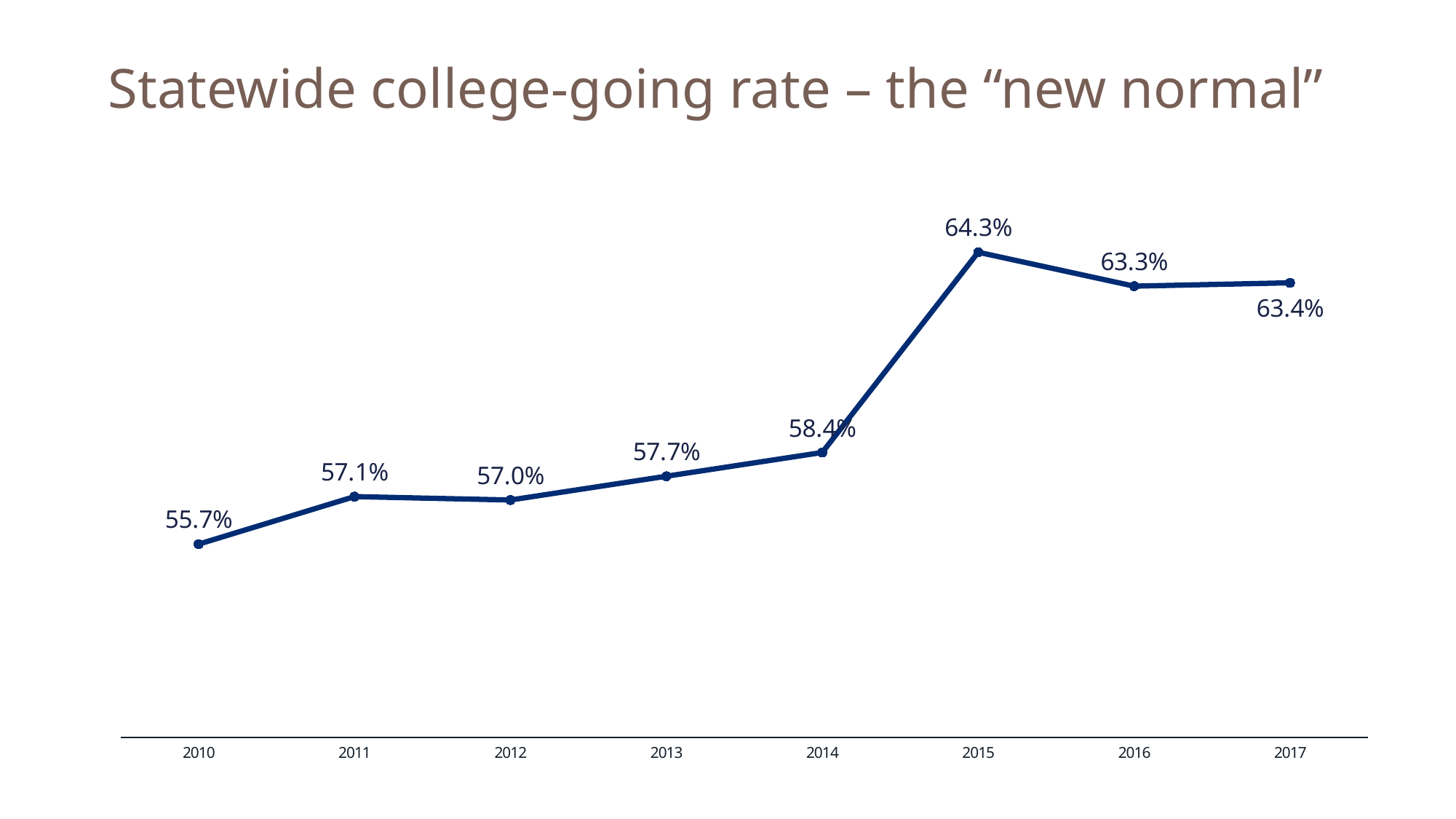
Which year has the lowest college-going rate? 2010 Which year has a higher college-going rate, 2011 or 2012? 2011 What is the college-going rate for 2015? 64.3% What is the difference between the college-going rate in 2017 and in 2010? 7.7% What is the college-going rate for 2010? 55.7% What kind of chart is shown on the slide? Line chart What is the title of the slide? Statewide college-going rate – the "new normal" What is the difference between the college-going rate in 2015 and in 2014? 5.9% What is the college-going rate for 2013? 57.7% What is the college-going rate for 2017? 63.4% Which year has the highest college-going rate? 2015 How many years are plotted on the chart? 8